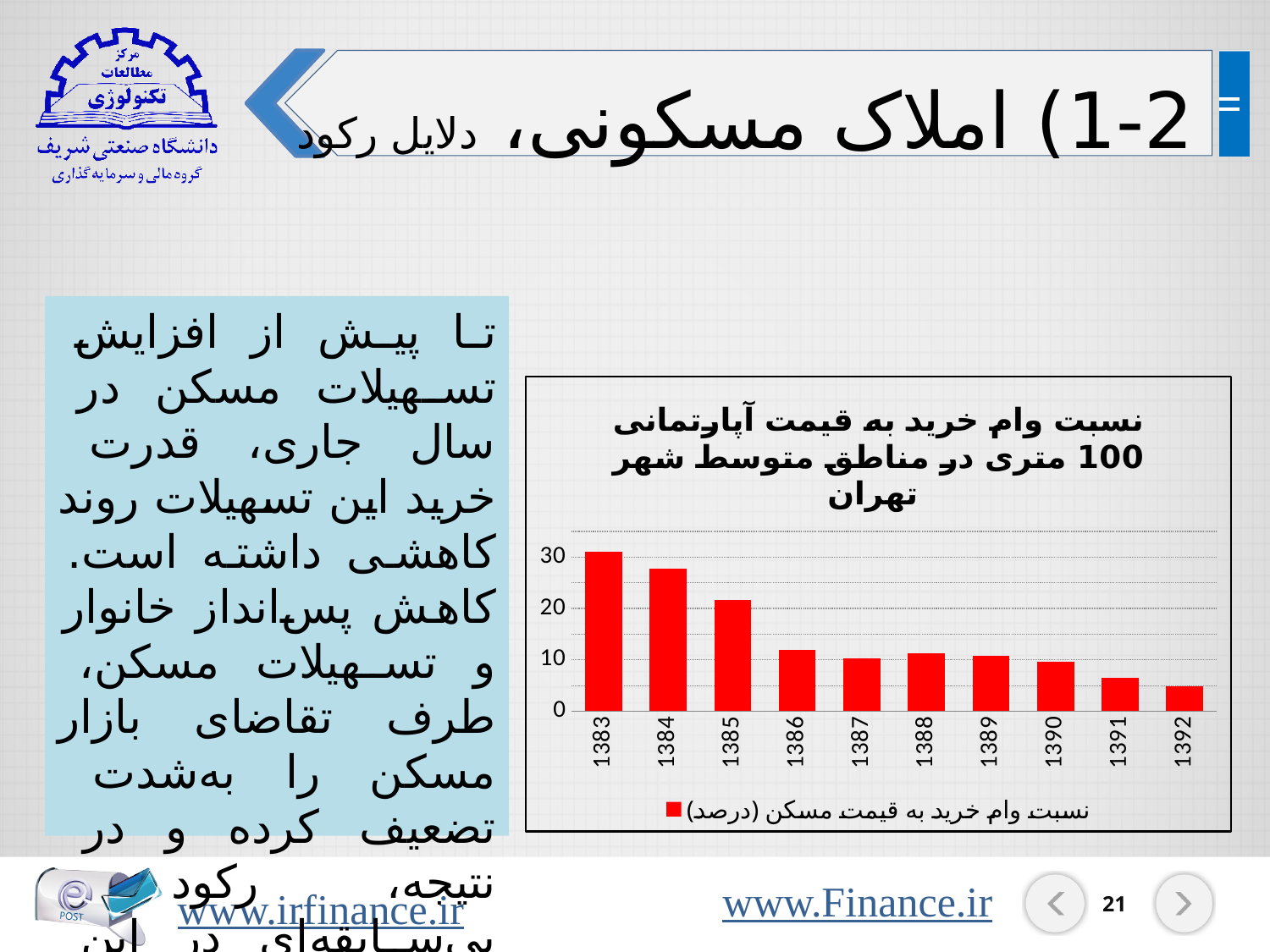
How many series does the chart's legend list? 1 Which year has the highest bar in the chart? 1383 Which is larger, the value for 1386 or the value for 1391? 1386 Do the values generally rise or fall from 1383 to 1392 along the x axis? fall Is the value for 1391 greater or less than 10? less Is the value for 1384 greater or less than 30? less What is the legend entry of the series shown in the chart? نسبت وام خرید به قیمت مسکن (درصد) Which year has the lowest bar in the chart? 1392 Is the value for 1383 greater or less than 20? greater How many years (categories) are plotted on the x axis of the chart? 10 What kind of chart is shown on the slide? bar chart Which is larger, the value for 1384 or the value for 1385? 1384